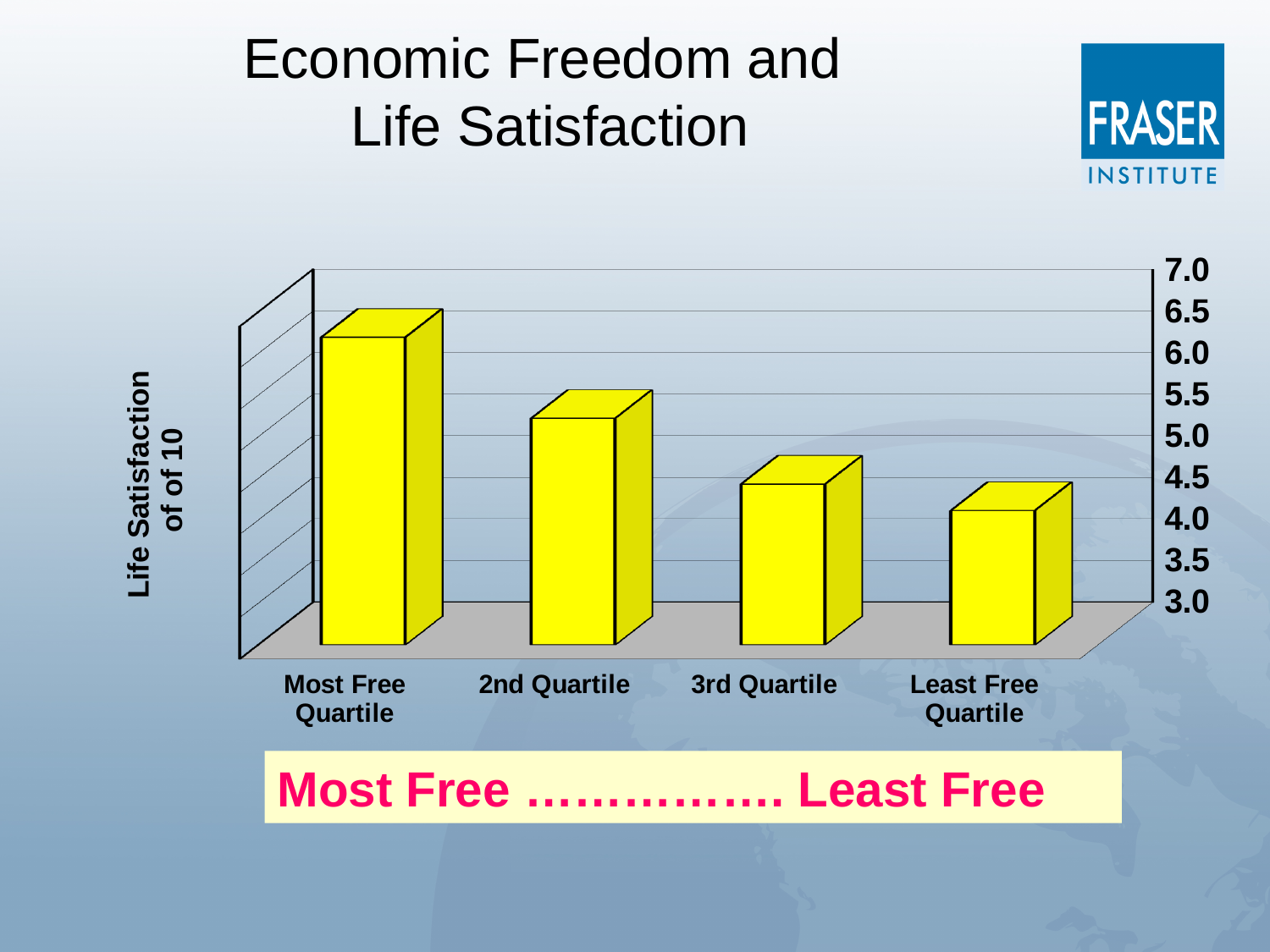
What kind of chart is shown on the slide? bar chart How many categories are plotted on the chart? 4 Which category has the highest life satisfaction value? Most Free Quartile What is the label on the vertical axis? Life Satisfaction of of 10 Which category has the lowest life satisfaction value? Least Free Quartile Is the value for the Most Free Quartile greater or less than 5.5? greater Is the value for the 2nd Quartile greater or less than 6.0? less Which is larger, the value for the 2nd Quartile or the 3rd Quartile? 2nd Quartile Do the values rise or fall moving from the Most Free Quartile to the Least Free Quartile? fall What is the title of the chart? Economic Freedom and Life Satisfaction